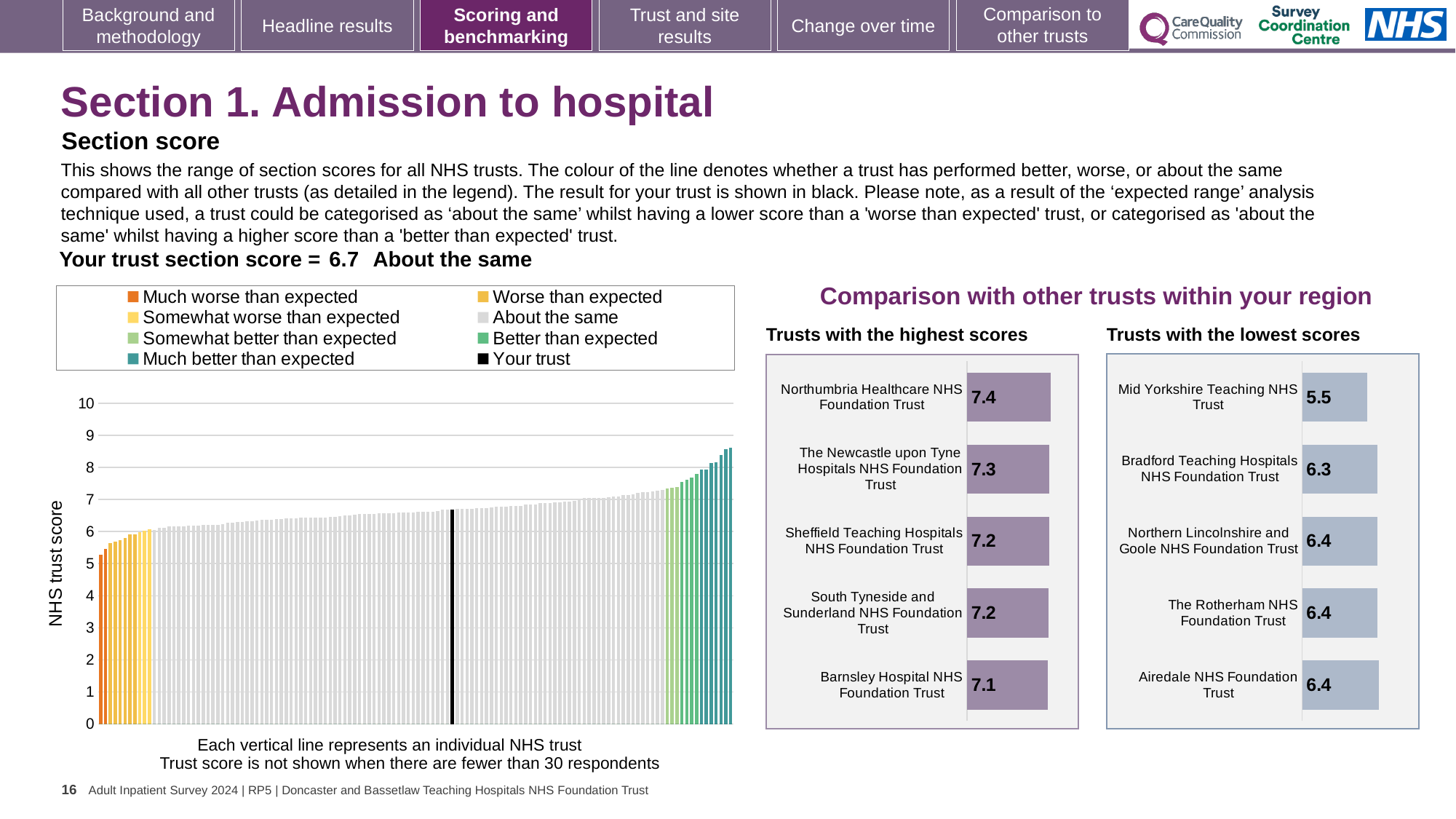
In the 'Trusts with the highest scores' chart, which trust has the highest score? Northumbria Healthcare NHS Foundation Trust In the 'Trusts with the lowest scores' chart, which trust has the lowest score? Mid Yorkshire Teaching NHS Trust In the 'Trusts with the highest scores' chart, what is the score for Northumbria Healthcare NHS Foundation Trust? 7.4 In the 'Trusts with the highest scores' chart, how many trusts are shown? 5 In the large chart on the left, do the trust scores rise or fall from left to right along the x axis? Rise What kind of chart is the large chart on the left showing NHS trust scores? Bar chart In the 'Trusts with the lowest scores' chart, what is the difference between the scores of Bradford Teaching Hospitals NHS Foundation Trust and Mid Yorkshire Teaching NHS Trust? 0.8 In the 'Trusts with the lowest scores' chart, what is the score for Mid Yorkshire Teaching NHS Trust? 5.5 In the 'Trusts with the highest scores' chart, what is the difference between the scores of Northumbria Healthcare NHS Foundation Trust and Barnsley Hospital NHS Foundation Trust? 0.3 In the 'Trusts with the lowest scores' chart, which has the larger score: Bradford Teaching Hospitals NHS Foundation Trust or Mid Yorkshire Teaching NHS Trust? Bradford Teaching Hospitals NHS Foundation Trust In the large chart on the left, is the value of the tallest bar greater or less than 8? greater In the 'Trusts with the highest scores' chart, what is the score for Barnsley Hospital NHS Foundation Trust? 7.1